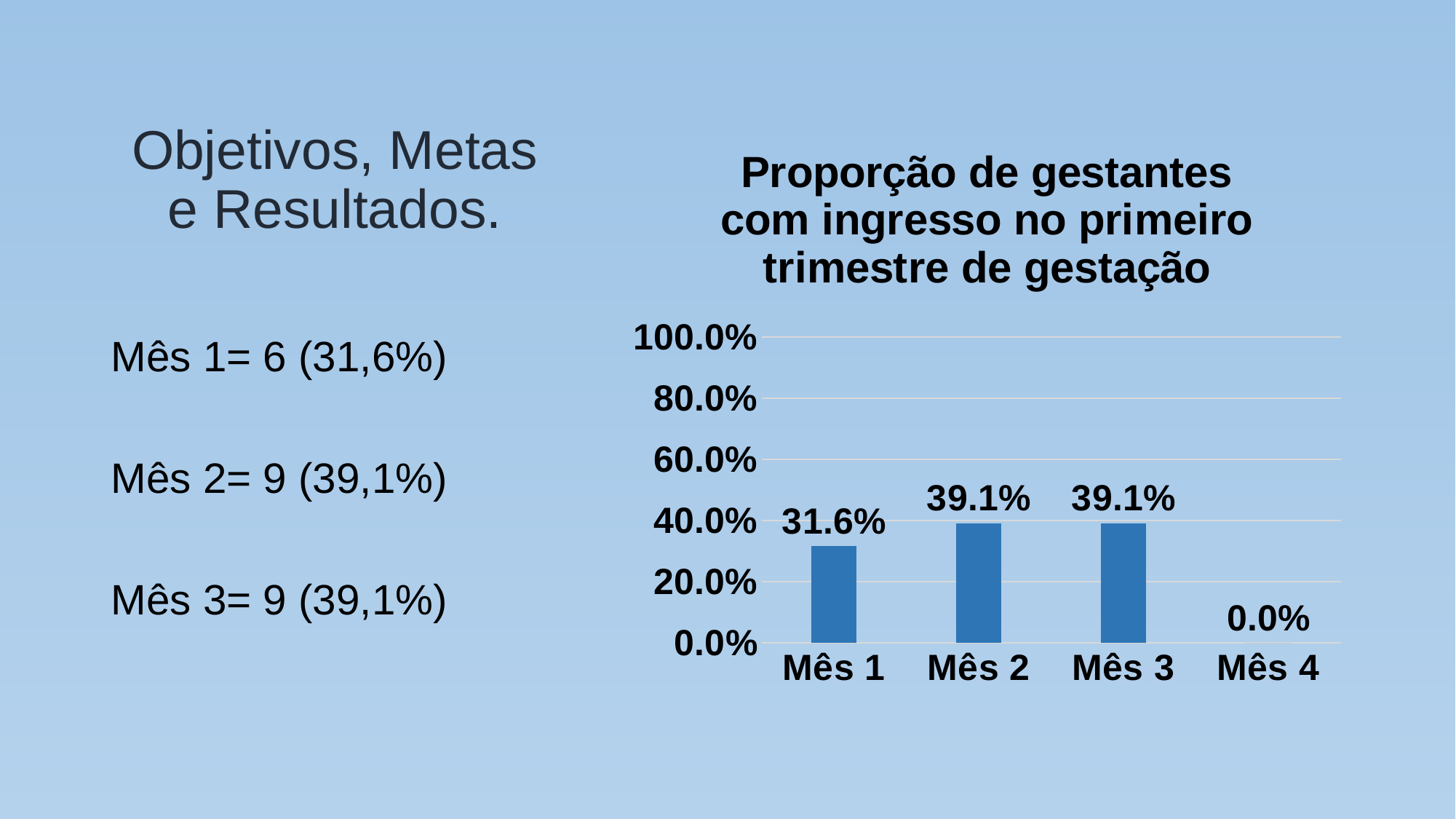
Which category has the lowest value? Mês 4 Which is larger, the value for Mês 1 or the value for Mês 3? Mês 3 How many categories are shown on the x axis? 4 Is the value for Mês 1 greater or less than 40.0%? less What is the difference between the values for Mês 2 and Mês 1? 7.5% Is the value for Mês 2 greater or less than 20.0%? greater What is the title of the chart? Proporção de gestantes com ingresso no primeiro trimestre de gestação What is the value for Mês 1? 31.6% What is the value for Mês 2? 39.1% What is the highest value shown on the y axis? 100.0% What kind of chart is shown on the slide? bar chart What is the value for Mês 4? 0.0%